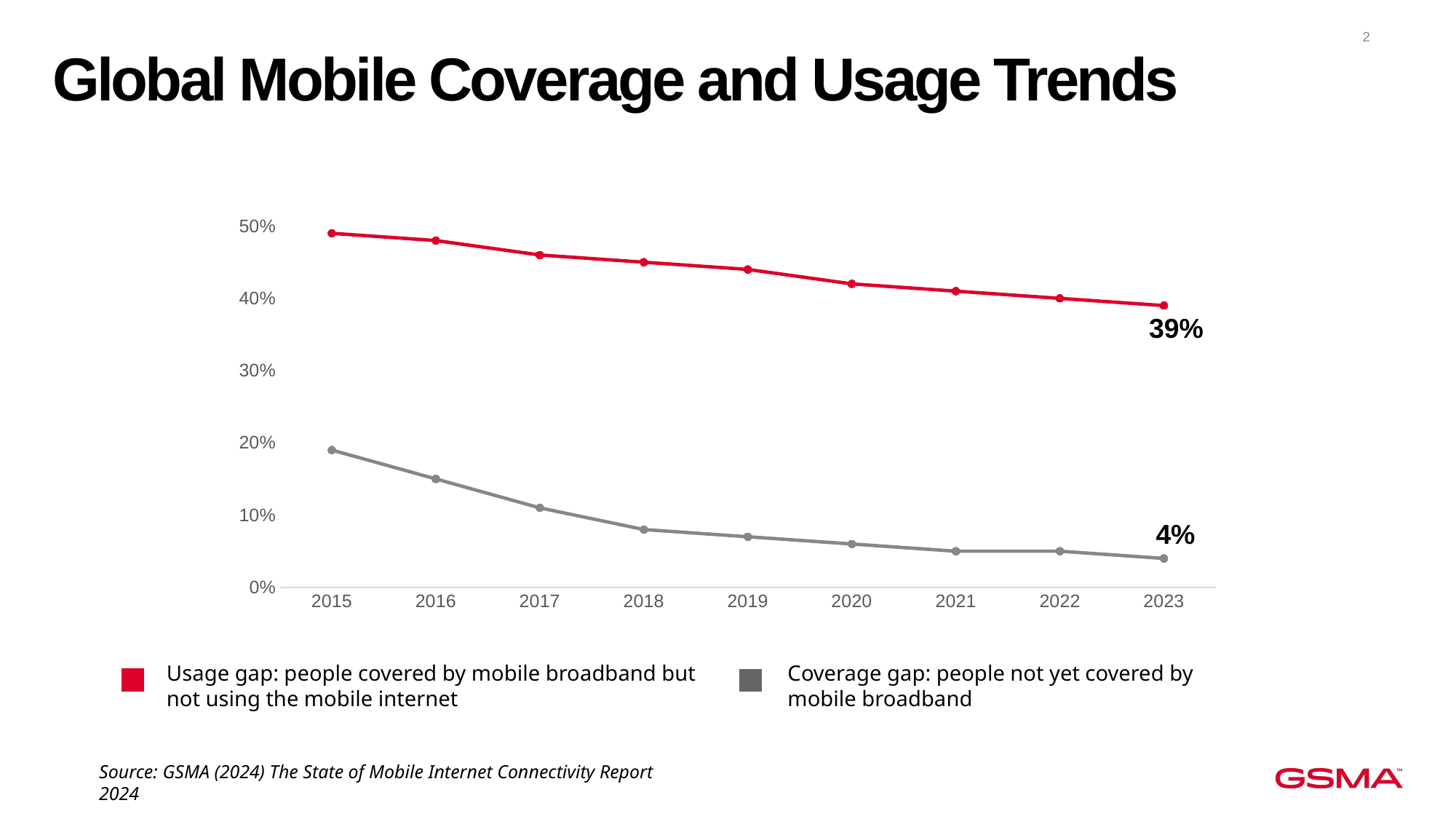
What kind of chart is shown on the slide? Line chart In which year is the coverage gap highest? 2015 How many series does the legend list? 2 Is the usage gap value for 2015 greater or less than 40%? greater How many years are plotted on the x axis? 9 Is the coverage gap value for 2018 greater or less than 10%? less What is the difference between the usage gap and the coverage gap in 2023? 35 percentage points In which year is the usage gap highest? 2015 In 2023, which is larger: the usage gap or the coverage gap? Usage gap Does the usage gap rise or fall from 2015 to 2023? Fall What is the coverage gap value shown for 2023? 4% What is the usage gap value shown for 2023? 39%